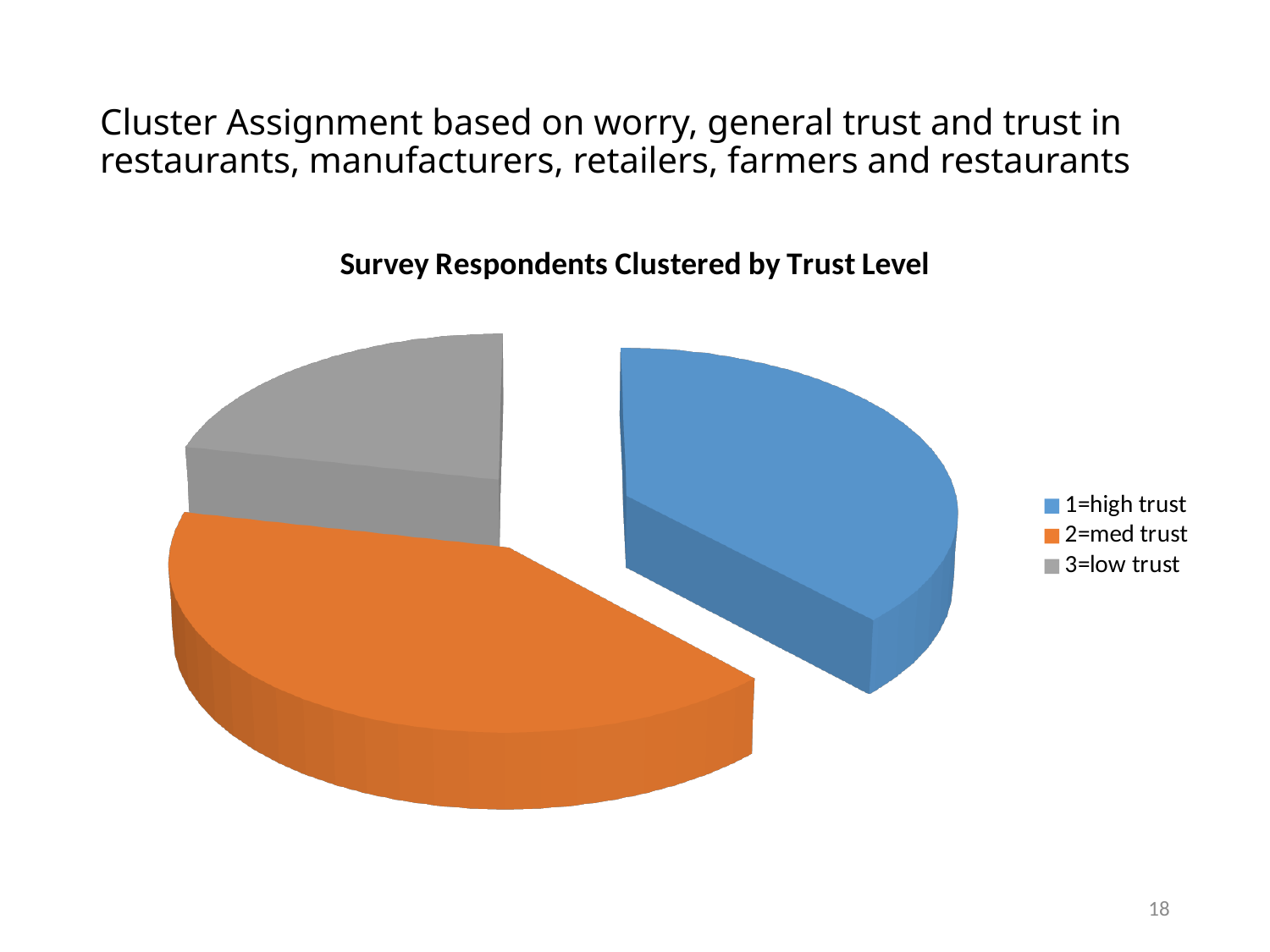
Which trust level has the smallest slice of the pie? 3=low trust Which slice is larger, 2=med trust or 1=high trust? 2=med trust Which slice is larger, 1=high trust or 3=low trust? 1=high trust What is the title of the chart? Survey Respondents Clustered by Trust Level How many entries does the legend list? 3 How many slices does the pie chart have? 3 What kind of chart is shown on the slide? Pie chart Which colour represents 2=med trust in the pie chart? Orange Which trust level has the largest slice of the pie? 2=med trust